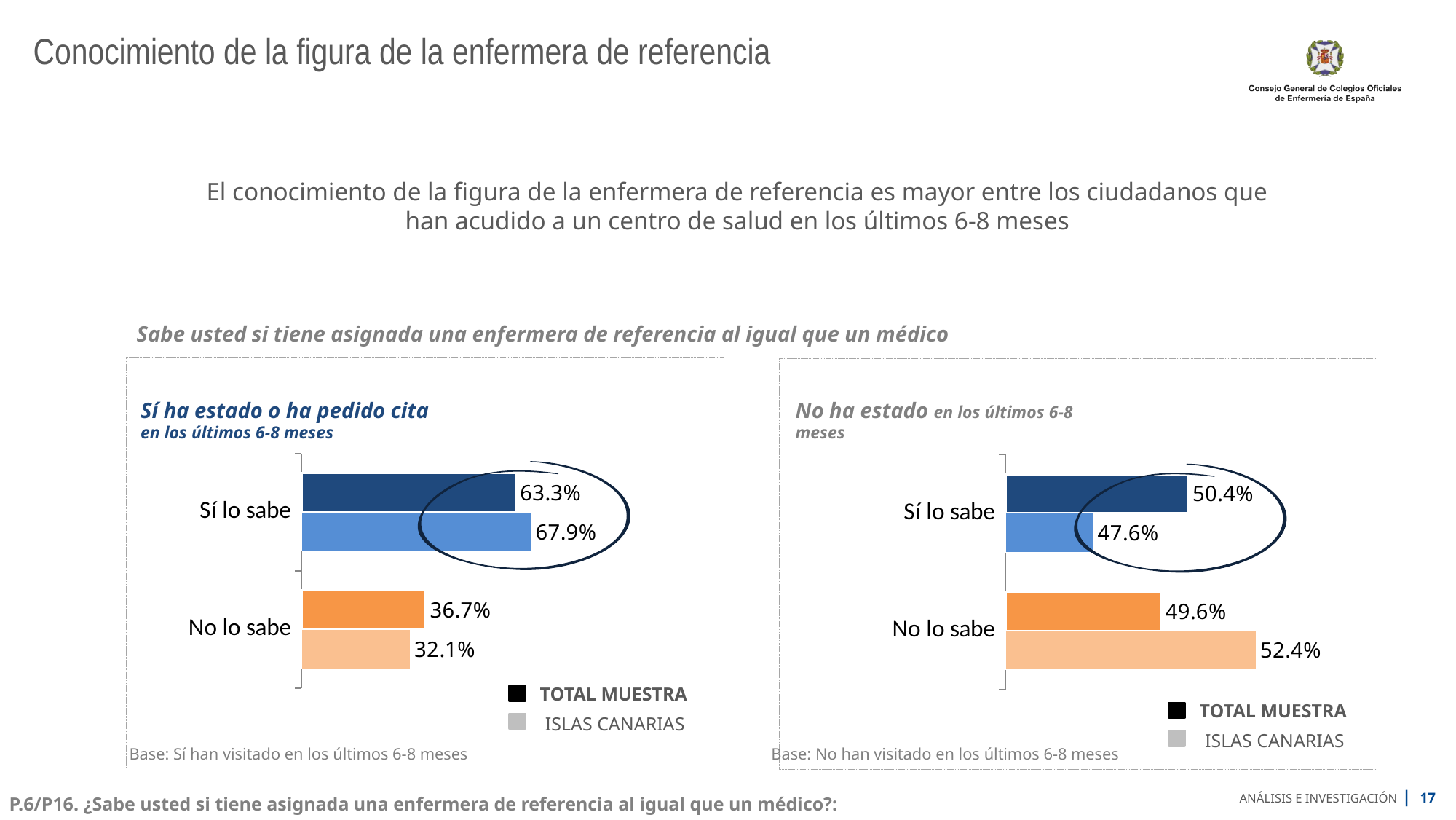
In the right chart (No ha estado en los últimos 6-8 meses), what is the ISLAS CANARIAS value for 'No lo sabe'? 52.4% In the left chart (Sí ha estado o ha pedido cita), what is the difference between the ISLAS CANARIAS and TOTAL MUESTRA values for 'Sí lo sabe'? 4.6% What type of chart is the left chart (Sí ha estado o ha pedido cita)? Bar chart In the right chart (No ha estado en los últimos 6-8 meses), what is the TOTAL MUESTRA value for 'Sí lo sabe'? 50.4% In the left chart (Sí ha estado o ha pedido cita), what is the ISLAS CANARIAS value for 'Sí lo sabe'? 67.9% In the left chart (Sí ha estado o ha pedido cita), what is the ISLAS CANARIAS value for 'No lo sabe'? 32.1% How many series does the legend of the left chart (Sí ha estado o ha pedido cita) list? 2 In the left chart (Sí ha estado o ha pedido cita), what is the TOTAL MUESTRA value for 'Sí lo sabe'? 63.3% How many categories are shown in the right chart (No ha estado en los últimos 6-8 meses)? 2 In the right chart (No ha estado en los últimos 6-8 meses), which is larger for ISLAS CANARIAS: 'Sí lo sabe' or 'No lo sabe'? No lo sabe In the right chart (No ha estado en los últimos 6-8 meses), what is the difference between the ISLAS CANARIAS and TOTAL MUESTRA values for 'No lo sabe'? 2.8% In the left chart (Sí ha estado o ha pedido cita), which category has the highest value across both series? Sí lo sabe